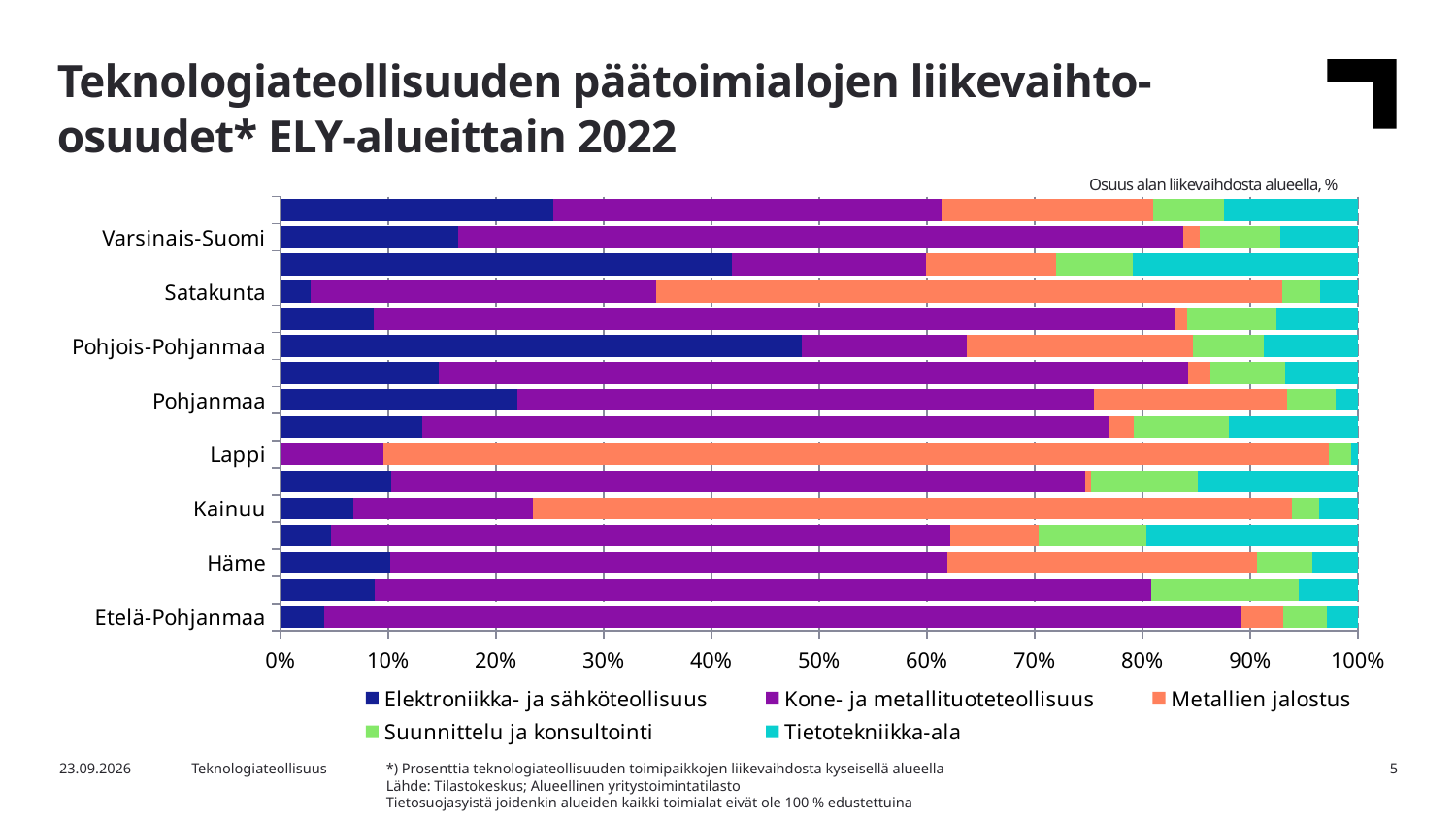
Is the Metallien jalostus share for Satakunta greater or less than 50%? greater Which region has the largest Elektroniikka- ja sähköteollisuus share, Pohjois-Pohjanmaa or Varsinais-Suomi? Pohjois-Pohjanmaa What kind of chart is shown on the slide? Stacked bar chart How many series does the legend list? 5 Is the Metallien jalostus share for Lappi greater or less than 80%? greater Is the Elektroniikka- ja sähköteollisuus share for Pohjois-Pohjanmaa greater or less than 40%? greater Which labelled region has the largest Metallien jalostus share? Lappi Which colour represents Tietotekniikka-ala in the legend? Teal (cyan) Which region has the larger Metallien jalostus share, Lappi or Etelä-Pohjanmaa? Lappi What is the maximum value shown on the horizontal axis? 100%